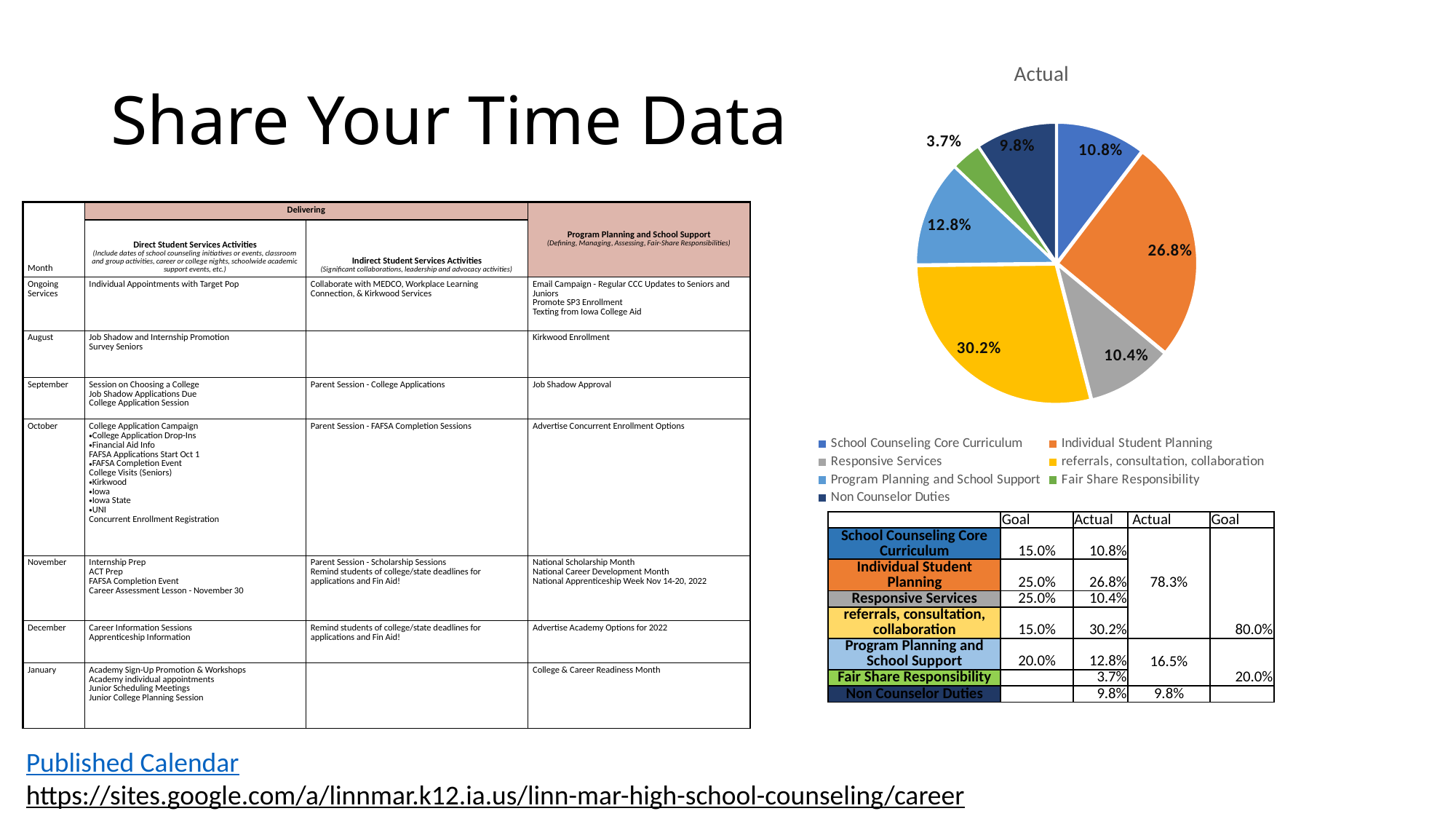
What is the value for Non Counselor Duties in the pie chart? 9.8% What colour is the Fair Share Responsibility slice in the pie chart? green Which is larger in the pie chart, School Counseling Core Curriculum or Program Planning and School Support? Program Planning and School Support Which category has the largest slice in the pie chart? referrals, consultation, collaboration What is the value for Individual Student Planning in the pie chart? 26.8% What is the value for Program Planning and School Support in the pie chart? 12.8% How many slices does the pie chart have? 7 What is the difference between the Individual Student Planning slice and the Responsive Services slice? 16.4% What share of the pie does Responsive Services represent? 10.4% Which category has the smallest slice in the pie chart? Fair Share Responsibility What type of chart is shown on the slide? pie chart What is the title of the pie chart? Actual